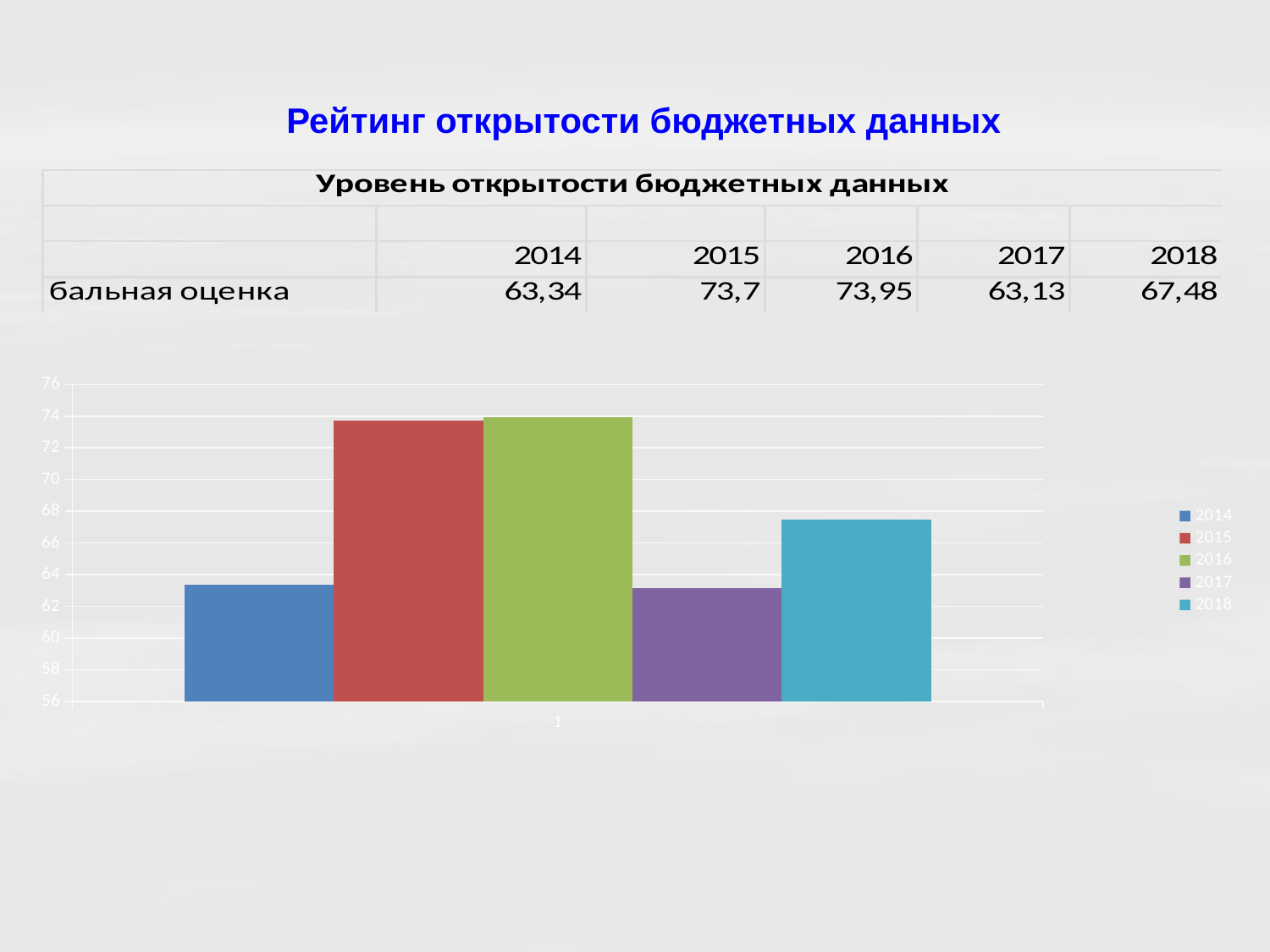
What is the difference between the values for 2018 and 2014? 4,14 Which year has the lowest бальная оценка? 2017 What colour is the bar for 2016 in the chart? green Is the value for 2018 greater or less than 66? greater What is the difference between the values for 2016 and 2017? 10,82 What is the бальная оценка value for 2014? 63,34 What is the бальная оценка value for 2018? 67,48 What is the бальная оценка value for 2016? 73,95 Which is larger, the value for 2015 or the value for 2018? 2015 Which year has the highest бальная оценка? 2016 What kind of chart is shown on the slide? bar chart How many series does the chart legend list? 5